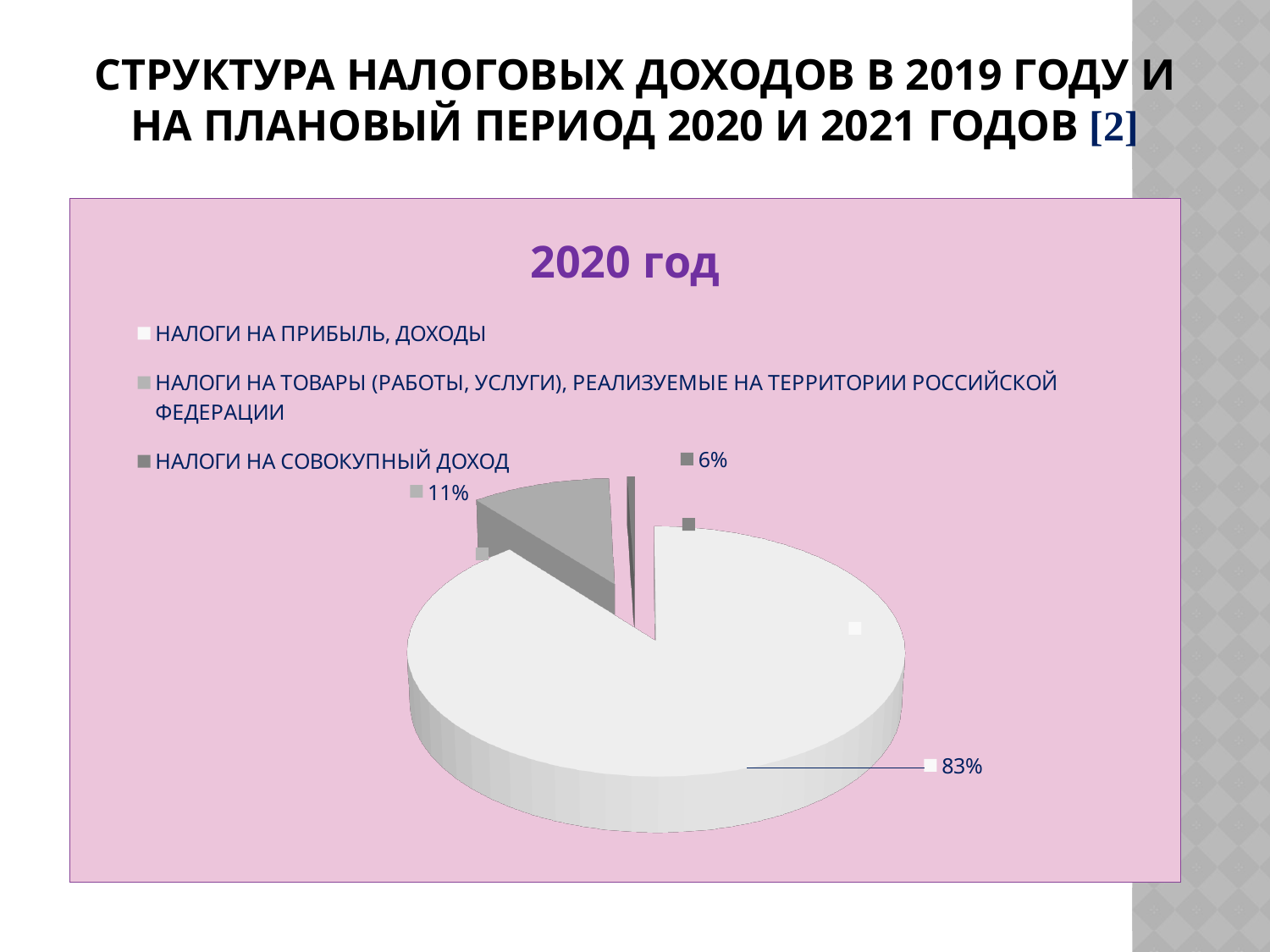
Which slice is larger: НАЛОГИ НА ТОВАРЫ (РАБОТЫ, УСЛУГИ), РЕАЛИЗУЕМЫЕ НА ТЕРРИТОРИИ РОССИЙСКОЙ ФЕДЕРАЦИИ or НАЛОГИ НА СОВОКУПНЫЙ ДОХОД? НАЛОГИ НА ТОВАРЫ (РАБОТЫ, УСЛУГИ), РЕАЛИЗУЕМЫЕ НА ТЕРРИТОРИИ РОССИЙСКОЙ ФЕДЕРАЦИИ Which category has the smallest slice of the pie? НАЛОГИ НА СОВОКУПНЫЙ ДОХОД What is the title of the chart? 2020 год Which legend entry is shown in white on the pie chart? НАЛОГИ НА ПРИБЫЛЬ, ДОХОДЫ What is the difference in percentage points between the slices for НАЛОГИ НА ТОВАРЫ (РАБОТЫ, УСЛУГИ), РЕАЛИЗУЕМЫЕ НА ТЕРРИТОРИИ РОССИЙСКОЙ ФЕДЕРАЦИИ and НАЛОГИ НА СОВОКУПНЫЙ ДОХОД? 5 Which category has the largest slice of the pie? НАЛОГИ НА ПРИБЫЛЬ, ДОХОДЫ What is the difference in percentage points between the slice for НАЛОГИ НА ПРИБЫЛЬ, ДОХОДЫ and the slice for НАЛОГИ НА СОВОКУПНЫЙ ДОХОД? 77 What kind of chart is shown on the slide? pie chart What share of the pie is labelled for НАЛОГИ НА ТОВАРЫ (РАБОТЫ, УСЛУГИ), РЕАЛИЗУЕМЫЕ НА ТЕРРИТОРИИ РОССИЙСКОЙ ФЕДЕРАЦИИ? 11% How many categories does the legend of the pie chart list? 3 What share of the pie is labelled for НАЛОГИ НА ПРИБЫЛЬ, ДОХОДЫ? 83% What share of the pie is labelled for НАЛОГИ НА СОВОКУПНЫЙ ДОХОД? 6%